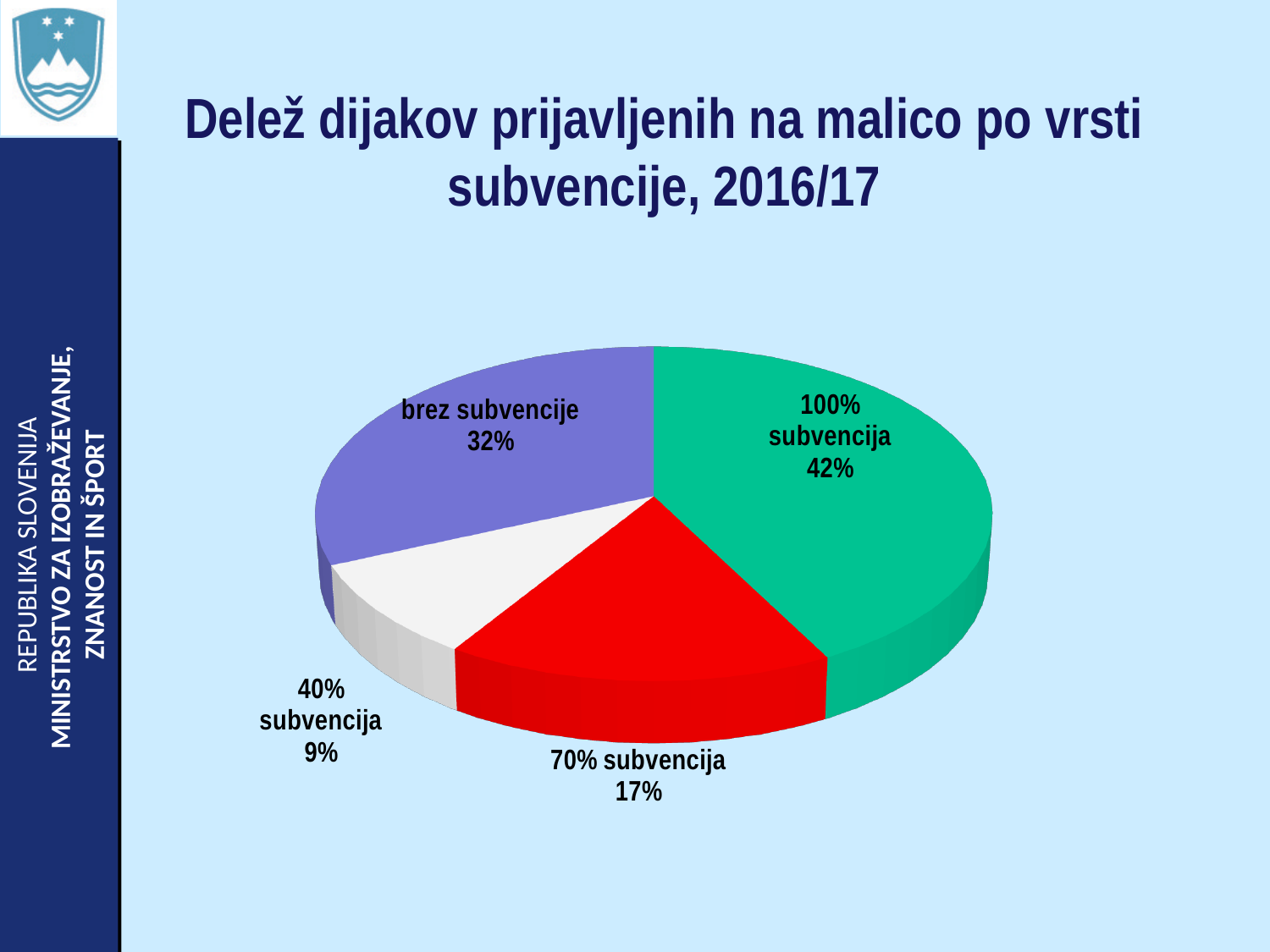
What share of the pie does the "100% subvencija" slice represent? 42% What kind of chart is shown on the slide? Pie chart Which is larger, the share for "70% subvencija" or the share for "40% subvencija"? 70% subvencija What share of the pie does the "brez subvencije" slice represent? 32% What is the difference in percentage points between the "100% subvencija" and "brez subvencije" slices? 10 What share of the pie does the "40% subvencija" slice represent? 9% Which category has the largest share of the pie? 100% subvencija What colour is the "70% subvencija" slice? Red Which category has the smallest share of the pie? 40% subvencija What is the title of the chart on the slide? Delež dijakov prijavljenih na malico po vrsti subvencije, 2016/17 How many slices does the pie chart have? 4